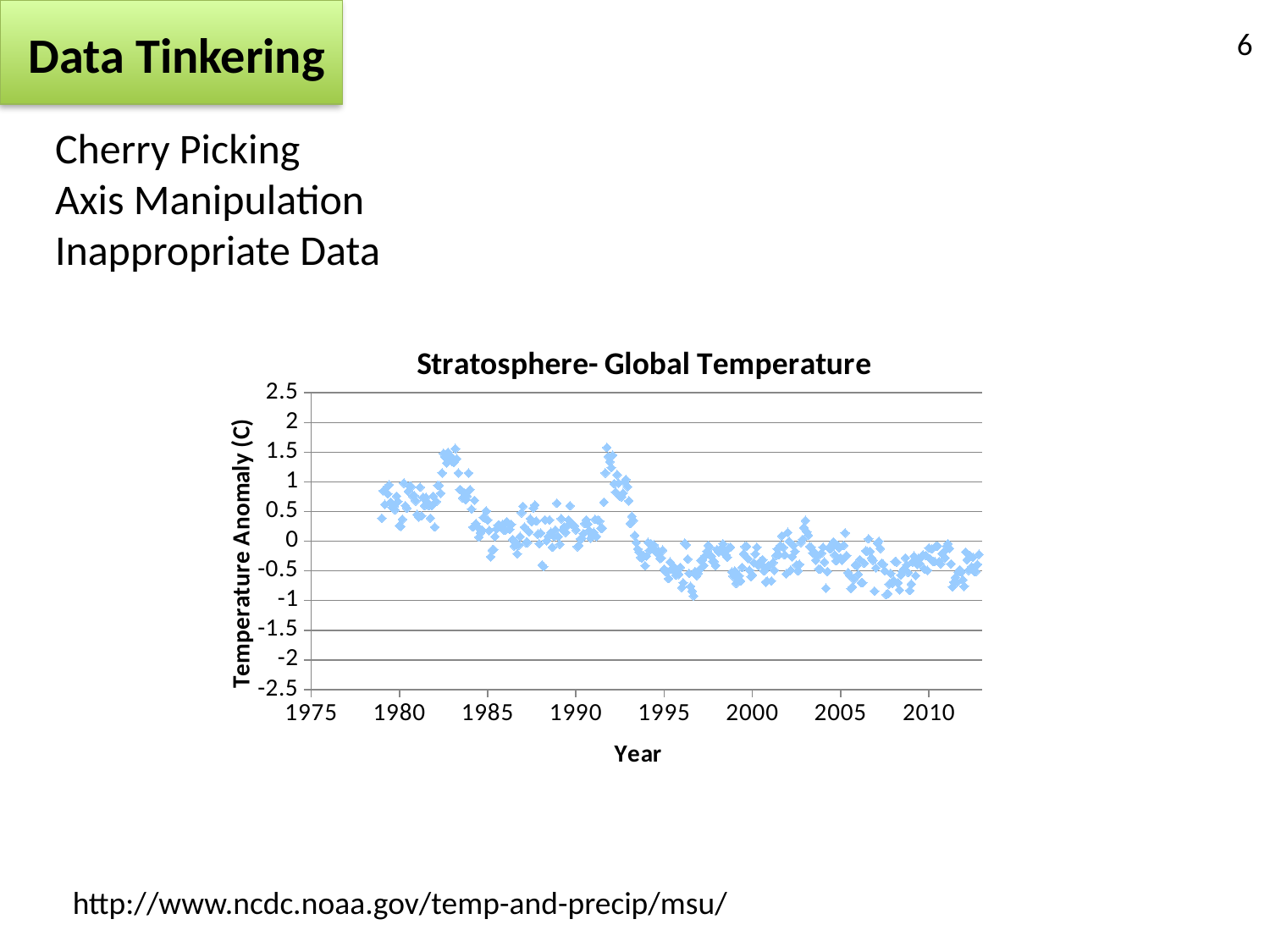
Are the temperature anomaly values around 2000 greater or less than 0? less Are the temperature anomaly values around 2008 greater or less than 0? less What is the title of the chart? Stratosphere- Global Temperature Which period has higher temperature anomaly values, around 1980 or around 2005? Around 1980 What kind of chart is shown on the slide? Scatter plot What is the highest value shown on the vertical axis of the chart? 2.5 What is the label of the vertical axis of the chart? Temperature Anomaly (C) Are the temperature anomaly values around 1980 greater or less than 0? greater Overall, do the temperature anomaly values rise or fall from 1980 to 2010? Fall